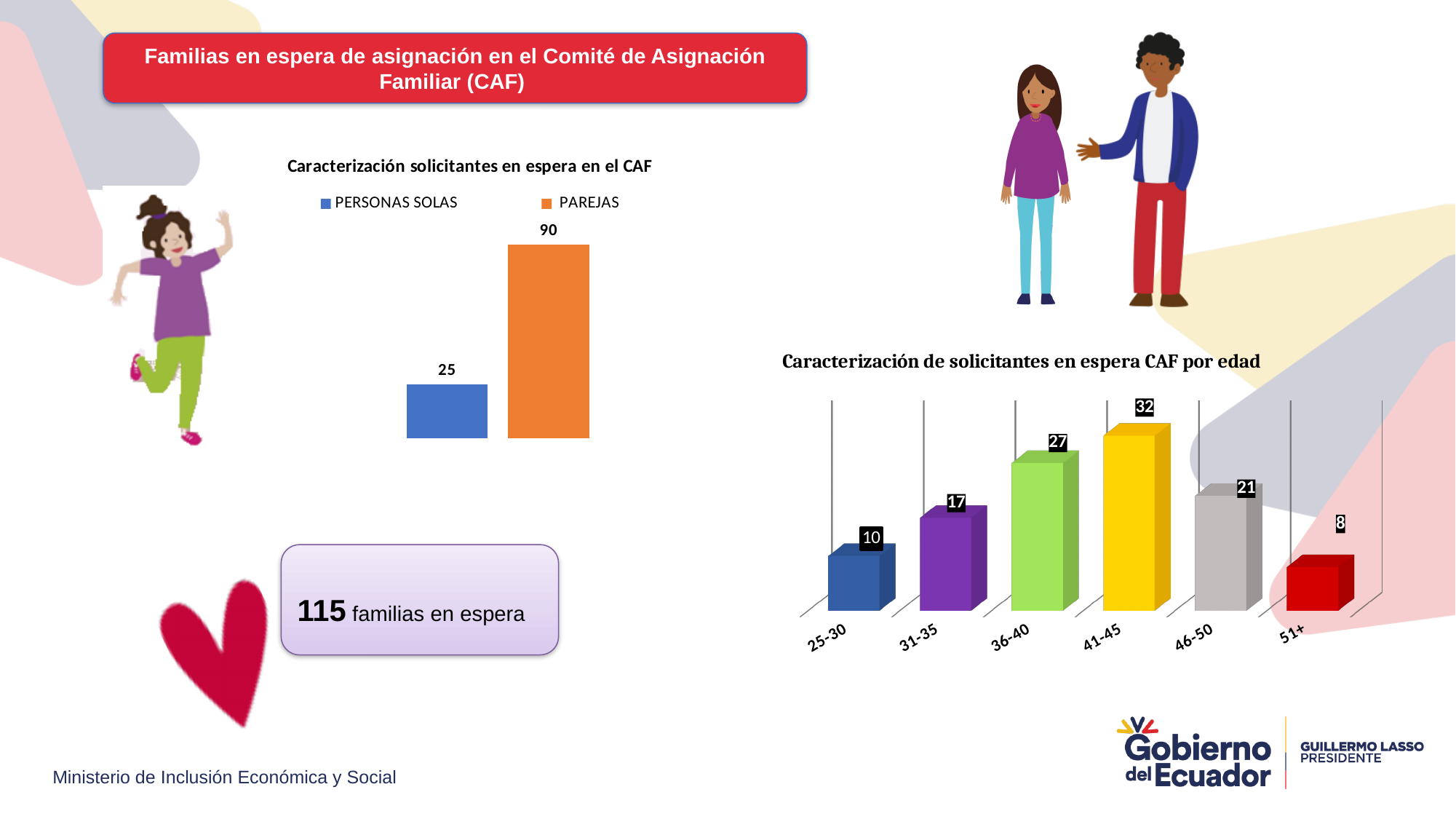
In the chart 'Caracterización de solicitantes en espera CAF por edad', what is the difference between the 36-40 and 31-35 age groups? 10 In the chart 'Caracterización de solicitantes en espera CAF por edad', which age group has the highest value? 41-45 In the chart 'Caracterización solicitantes en espera en el CAF', what is the value for PERSONAS SOLAS? 25 What kind of chart is 'Caracterización de solicitantes en espera CAF por edad'? Bar chart In the chart 'Caracterización de solicitantes en espera CAF por edad', which age group has the lowest value? 51+ In the chart 'Caracterización de solicitantes en espera CAF por edad', how many age groups are shown? 6 In the chart 'Caracterización de solicitantes en espera CAF por edad', what is the value for the 51+ age group? 8 In the chart 'Caracterización solicitantes en espera en el CAF', how many series does the legend list? 2 In the chart 'Caracterización solicitantes en espera en el CAF', what is the difference between PAREJAS and PERSONAS SOLAS? 65 In the chart 'Caracterización solicitantes en espera en el CAF', which colour represents PAREJAS? Orange In the chart 'Caracterización solicitantes en espera en el CAF', what is the value for PAREJAS? 90 In the chart 'Caracterización de solicitantes en espera CAF por edad', what is the value for the 41-45 age group? 32